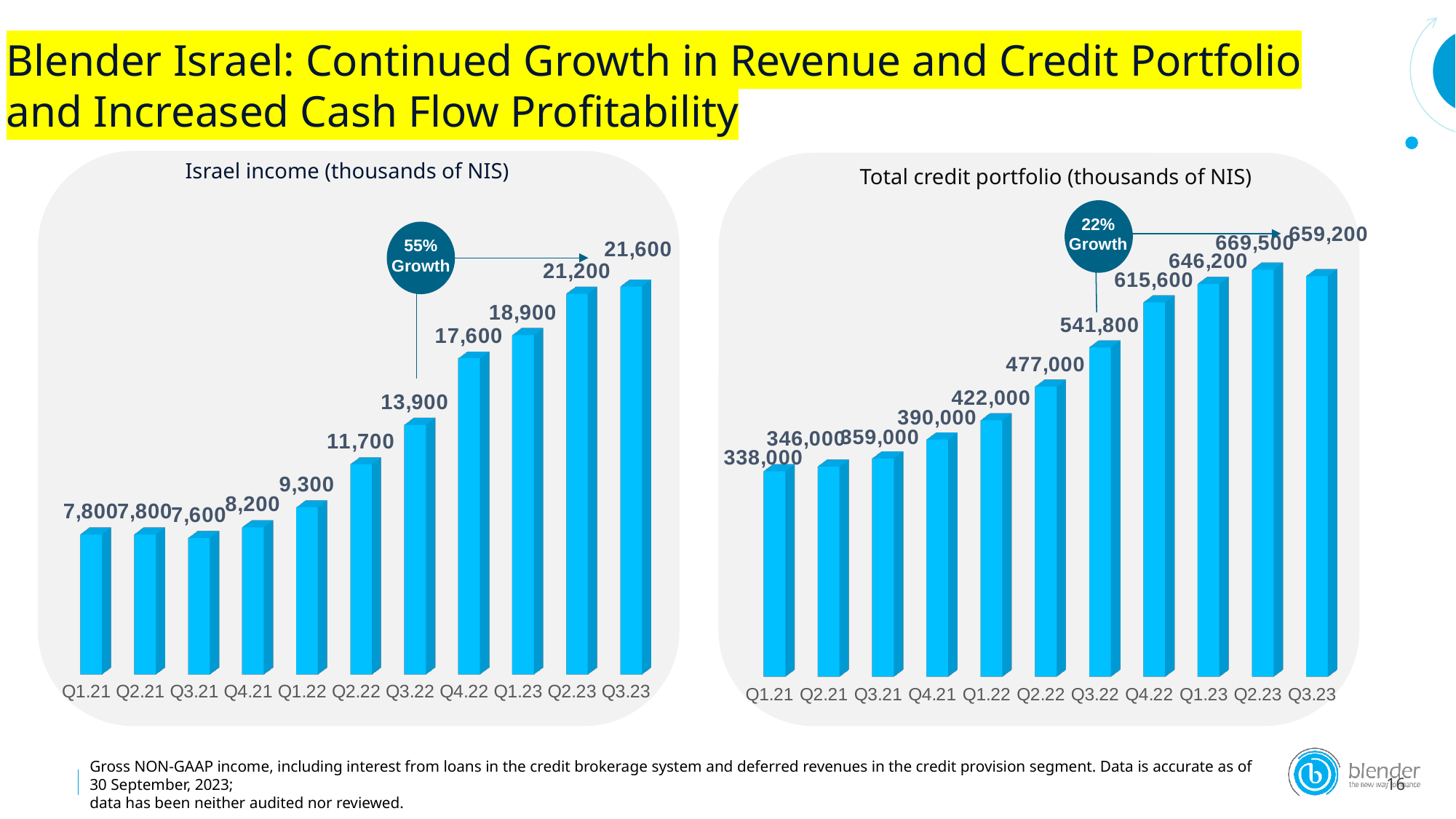
What growth percentage is shown in the callout on the Israel income chart? 55% Growth What kind of chart is the Total credit portfolio chart? Bar chart How many quarters are shown in the Israel income chart? 11 In the Israel income chart, what is the difference between the Q3.23 and Q3.22 values? 7,700 In the Total credit portfolio chart, which quarter has the highest value? Q2.23 In the Total credit portfolio chart, what is the difference between the Q2.23 and Q3.23 values? 10,300 In the Israel income chart, which quarter has the lowest value? Q3.21 In the Israel income chart, what is the value for Q3.22? 13,900 In the Total credit portfolio chart, which is larger, the value for Q2.23 or Q3.23? Q2.23 In the Total credit portfolio chart, what is the value for Q4.22? 615,600 In the Total credit portfolio chart, what is the value for Q1.21? 338,000 In the Israel income chart, what is the value for Q3.23? 21,600